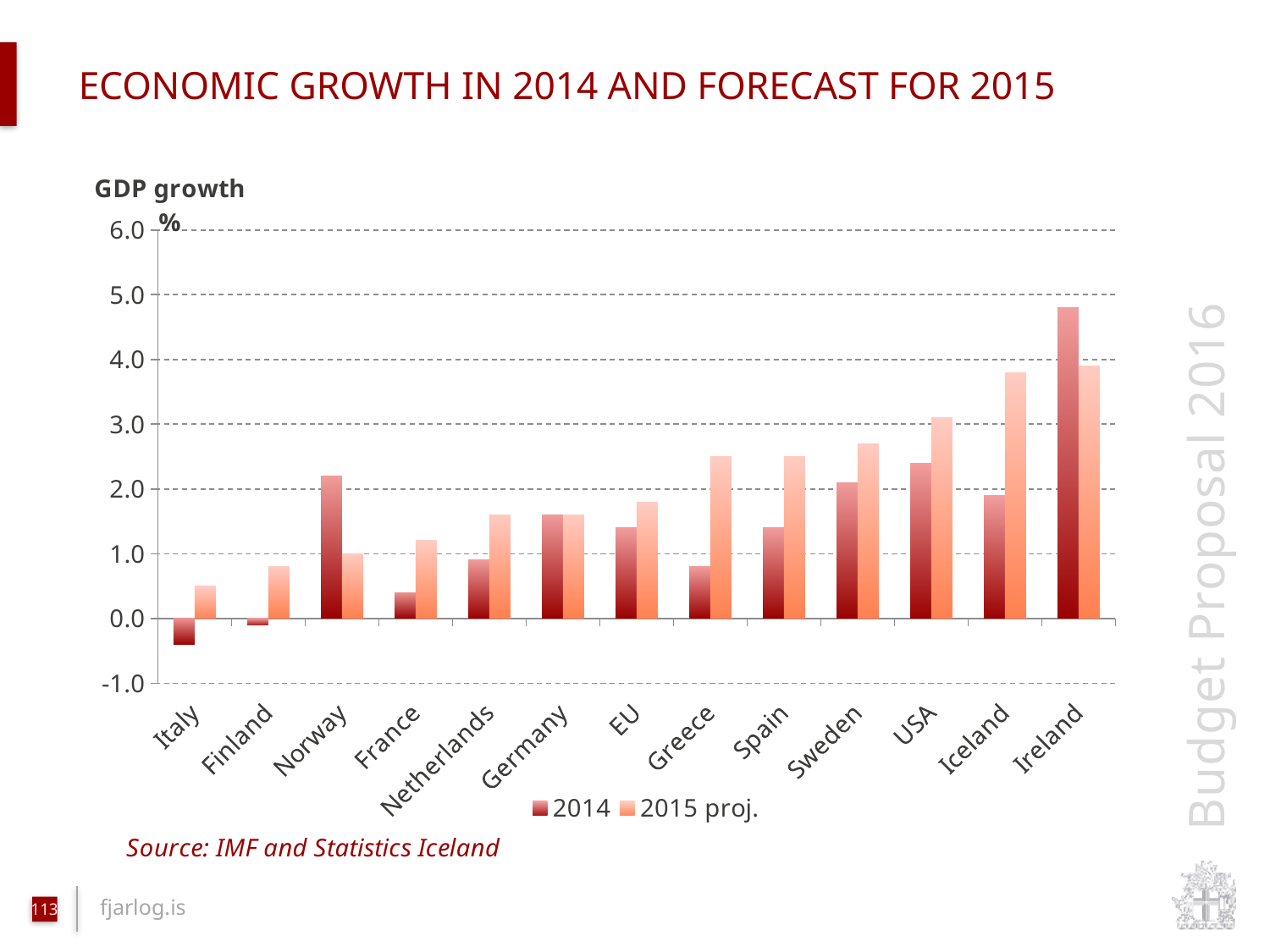
What are the two series named in the legend? 2014 and 2015 proj. Is the 2015 projected GDP growth value for Iceland greater or less than 3.0? greater Which country has the lowest projected GDP growth for 2015? Italy Which country has the highest projected GDP growth for 2015? Ireland How many countries or regions are shown on the x axis of the chart? 13 Is the 2014 GDP growth value for Italy greater or less than 0.0? less Which country has the highest GDP growth for 2014? Ireland Is the 2014 GDP growth value for Ireland greater or less than 4.0? greater Which country has the lowest GDP growth for 2014? Italy What kind of chart is shown on the slide? bar chart For Norway, which is larger: the 2014 value or the 2015 projected value? 2014 How many series does the legend list? 2